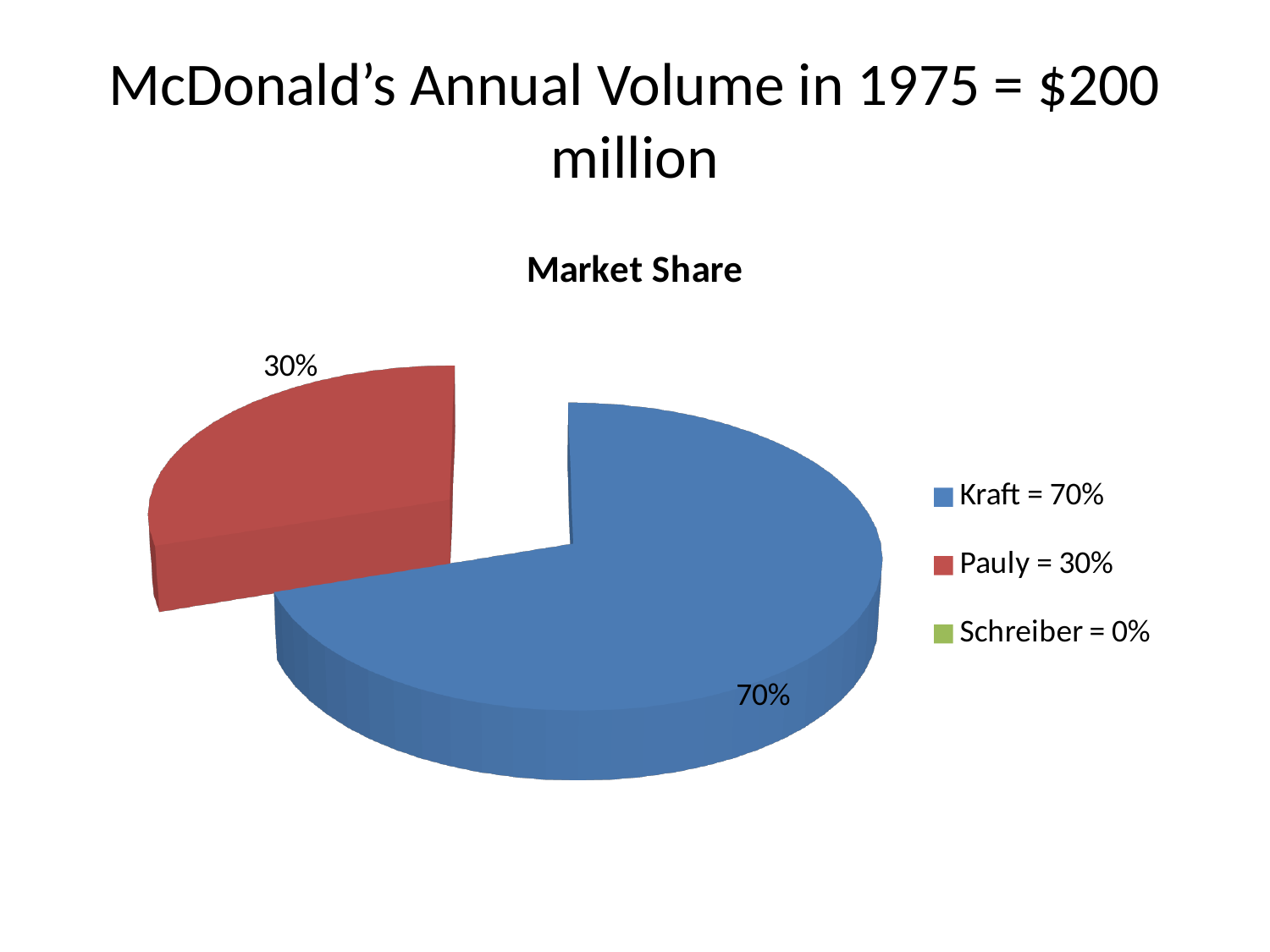
How many entries does the legend list? 3 What is the difference in market share between Kraft and Pauly? 40% Which company has the smallest market share? Schreiber What share of the pie does the Kraft slice represent? 70% Which company has the largest market share? Kraft Which has a larger market share, Pauly or Kraft? Kraft What type of chart is shown on the slide? Pie chart What colour is the slice representing Pauly? Red What market share does Schreiber hold according to the legend? 0% What is the chart's title? Market Share What market share does Kraft hold according to the chart? 70% What market share does Pauly hold according to the chart? 30%